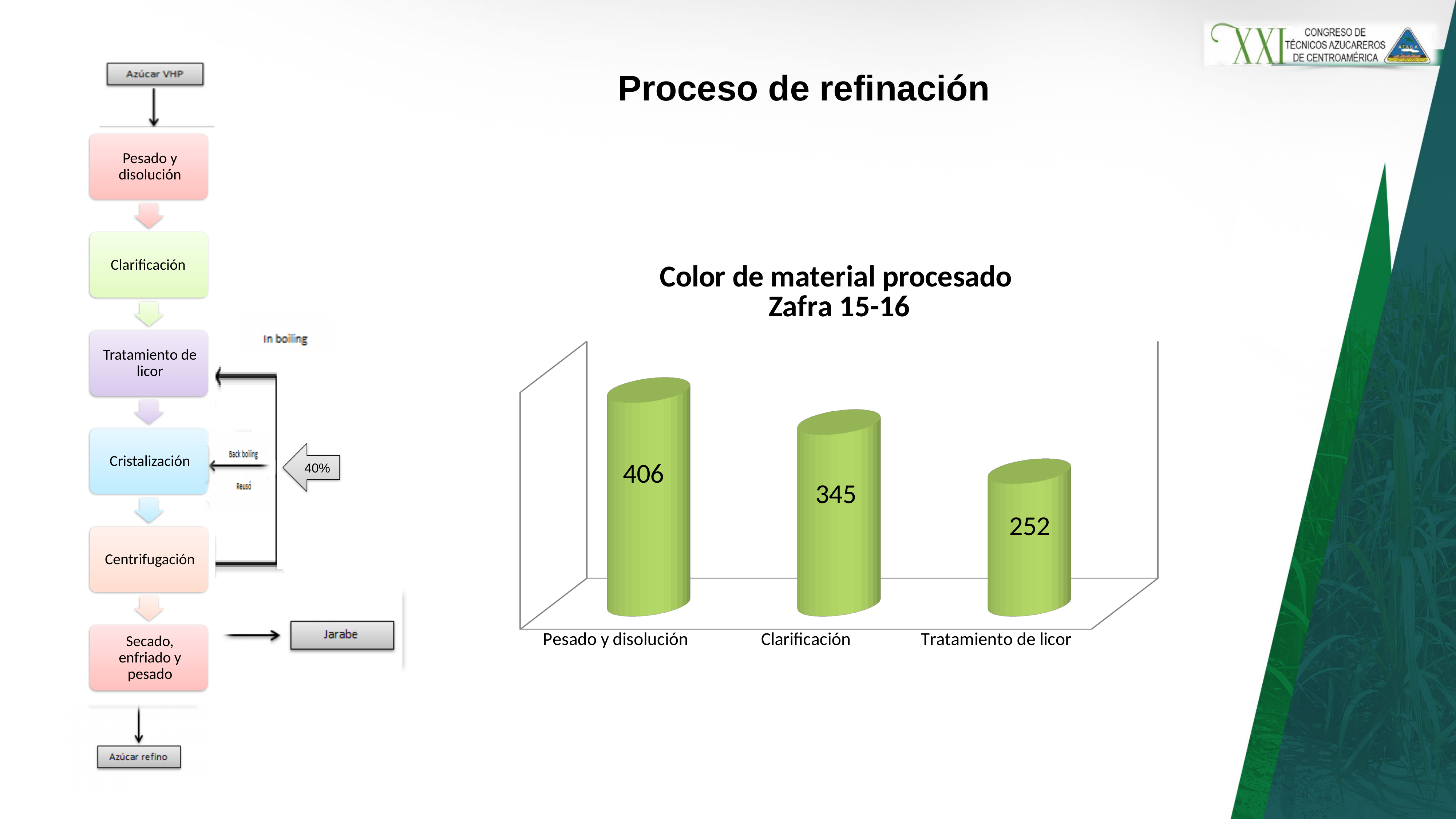
What is the title of the chart? Color de material procesado Zafra 15-16 Which is larger, the value for Clarificación or the value for Tratamiento de licor? Clarificación Which category has the lowest value in the chart? Tratamiento de licor Which category has the highest value in the chart? Pesado y disolución What is the value for Tratamiento de licor in the chart? 252 What is the difference between the values for Pesado y disolución and Clarificación? 61 Do the values rise or fall from left to right across the categories? Fall What is the difference between the values for Clarificación and Tratamiento de licor? 93 What kind of chart is shown on the slide? Bar chart What is the value for Pesado y disolución in the chart? 406 What is the value for Clarificación in the chart? 345 How many categories are shown in the chart? 3